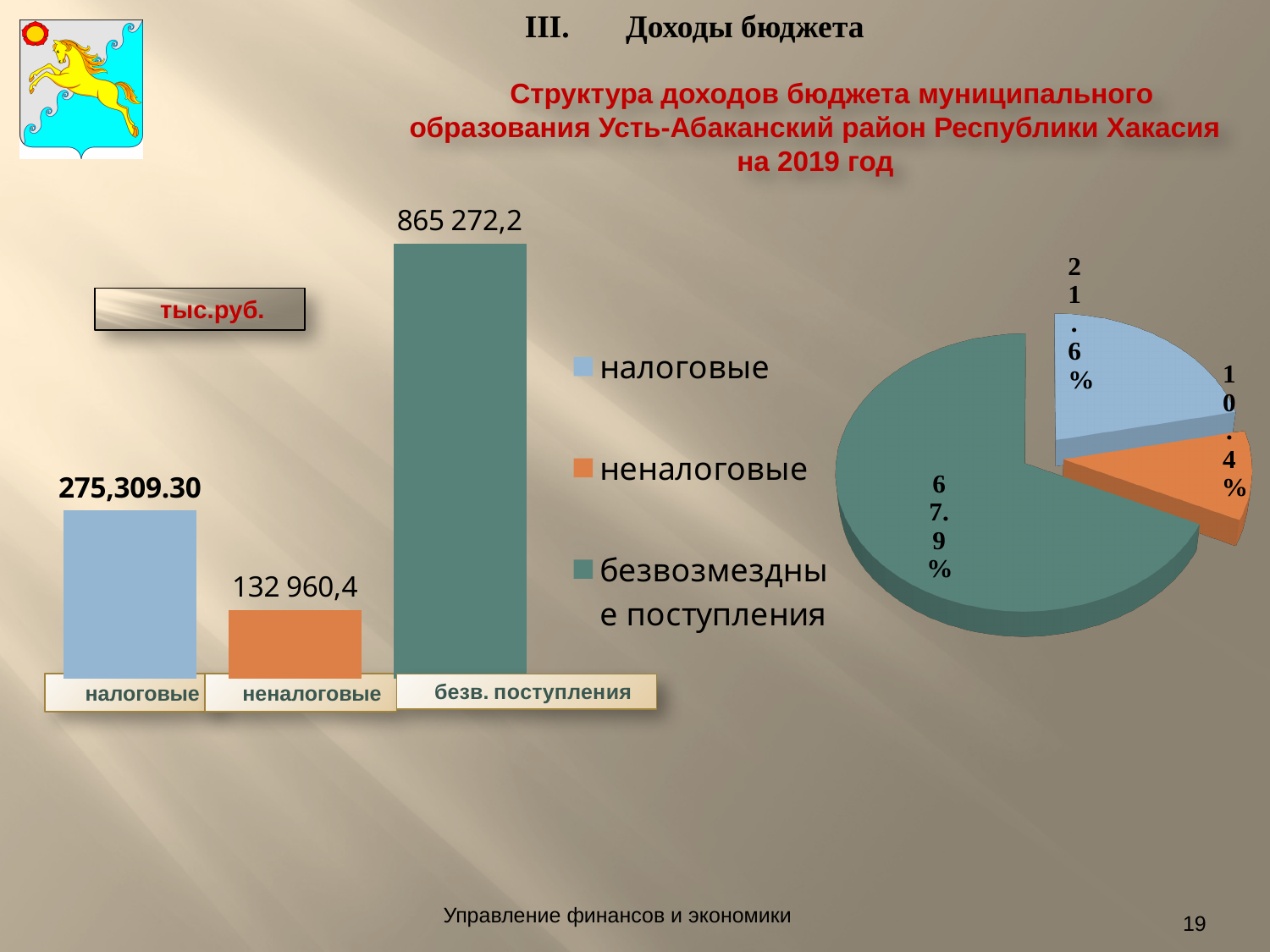
How many entries does the legend between the two charts list? 3 On the bar chart on the left, which is larger: налоговые or неналоговые? налоговые On the bar chart on the left, which category has the lowest value? неналоговые On the pie chart on the right, what share is shown for the налоговые slice? 21.6% What type of chart is shown on the left of the slide? bar chart On the bar chart on the left, what is the value for налоговые? 275,309.30 On the bar chart on the left, what is the value for неналоговые? 132 960,4 On the bar chart on the left, what is the value for безв. поступления? 865 272,2 On the pie chart on the right, what share is shown for the largest slice (безвозмездные поступления)? 67.9% On the bar chart on the left, which category has the highest value? безв. поступления On the bar chart on the left, how many bars are shown? 3 On the pie chart on the right, what share is shown for the неналоговые slice? 10.4%